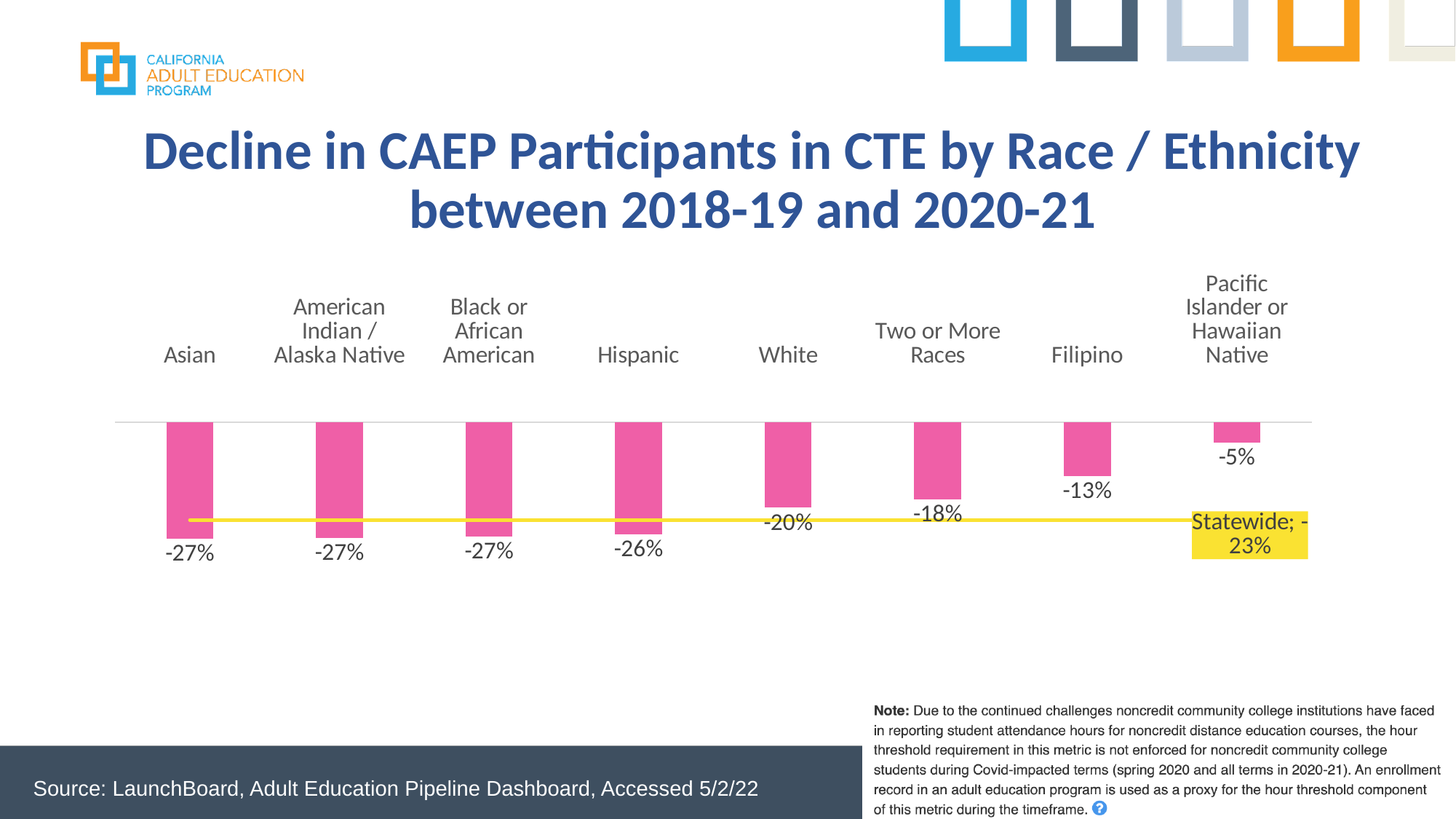
How many race / ethnicity categories are shown in the chart? 8 What is the value for Filipino? -13% What is the Statewide value shown by the horizontal line? -23% What is the difference between the values for Filipino and Pacific Islander or Hawaiian Native? 8 percentage points What is the value for White? -20% What is the title of the slide? Decline in CAEP Participants in CTE by Race / Ethnicity between 2018-19 and 2020-21 Which category shows the smallest decline? Pacific Islander or Hawaiian Native What is the value for Pacific Islander or Hawaiian Native? -5% What kind of chart is shown on the slide? Combination bar and line chart (bars with a Statewide line) What is the value for Two or More Races? -18% Which shows a larger decline, White or Two or More Races? White What is the value for Hispanic? -26%